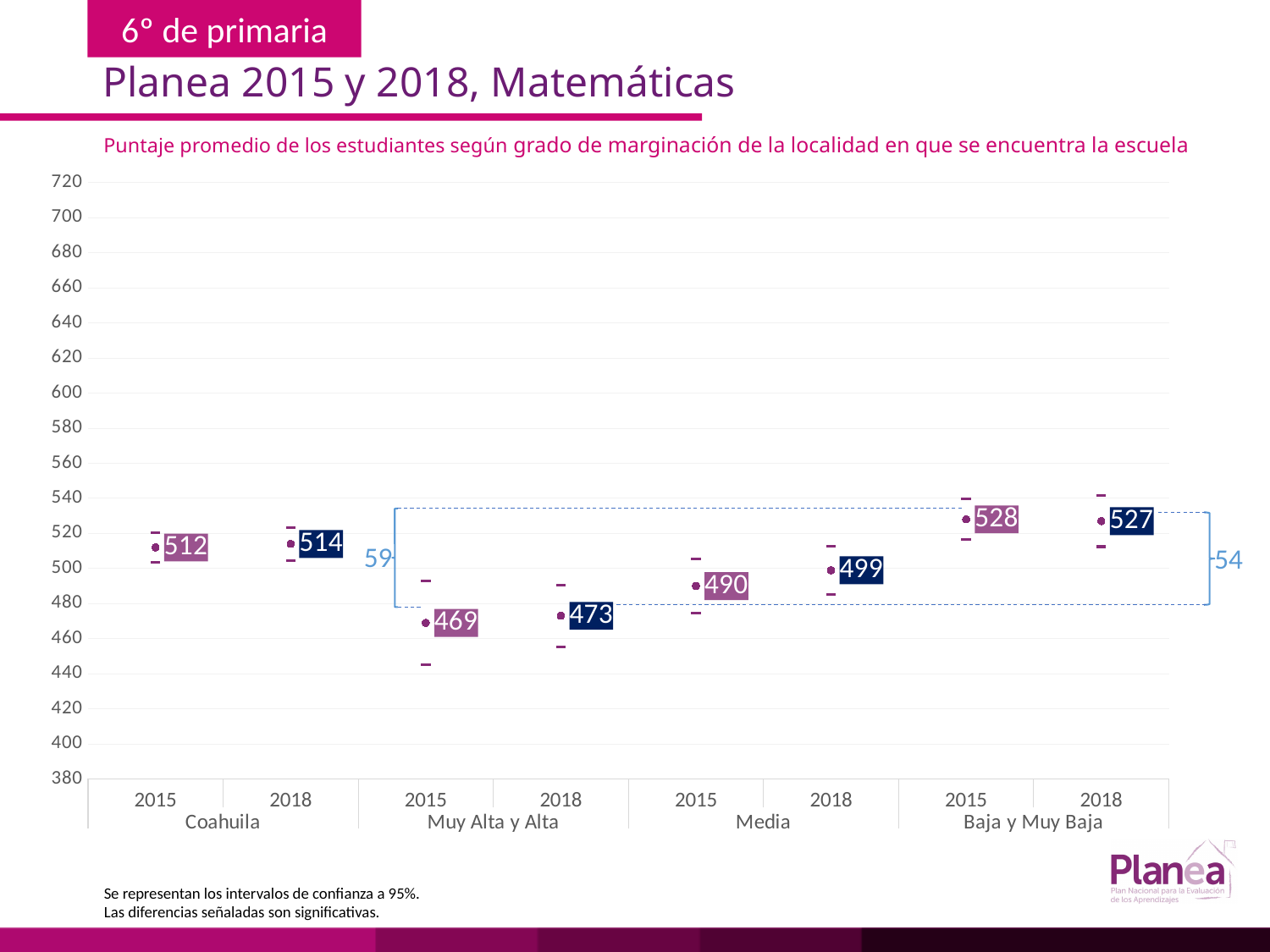
What is the difference between the 2015 scores of Baja y Muy Baja and Muy Alta y Alta? 59 Which is larger, the 2018 score for Coahuila or the 2018 score for the Media group? Coahuila (514) What is the 2015 average score for Coahuila? 512 Which group and year has the highest average score on the chart? Baja y Muy Baja, 2015 (528) How many data points (group-year combinations) are plotted on the chart? 8 Which group and year has the lowest average score on the chart? Muy Alta y Alta, 2015 (469) What is the 2015 average score for the Baja y Muy Baja marginación group? 528 Is the 2015 score for the Muy Alta y Alta group greater or less than 480? less What is the 2018 average score for the Muy Alta y Alta marginación group? 473 What is the subtitle of the chart? Puntaje promedio de los estudiantes según grado de marginación de la localidad en que se encuentra la escuela What is the difference between the 2018 and 2015 scores for the Media group? 9 What is the 2018 average score for the Media marginación group? 499